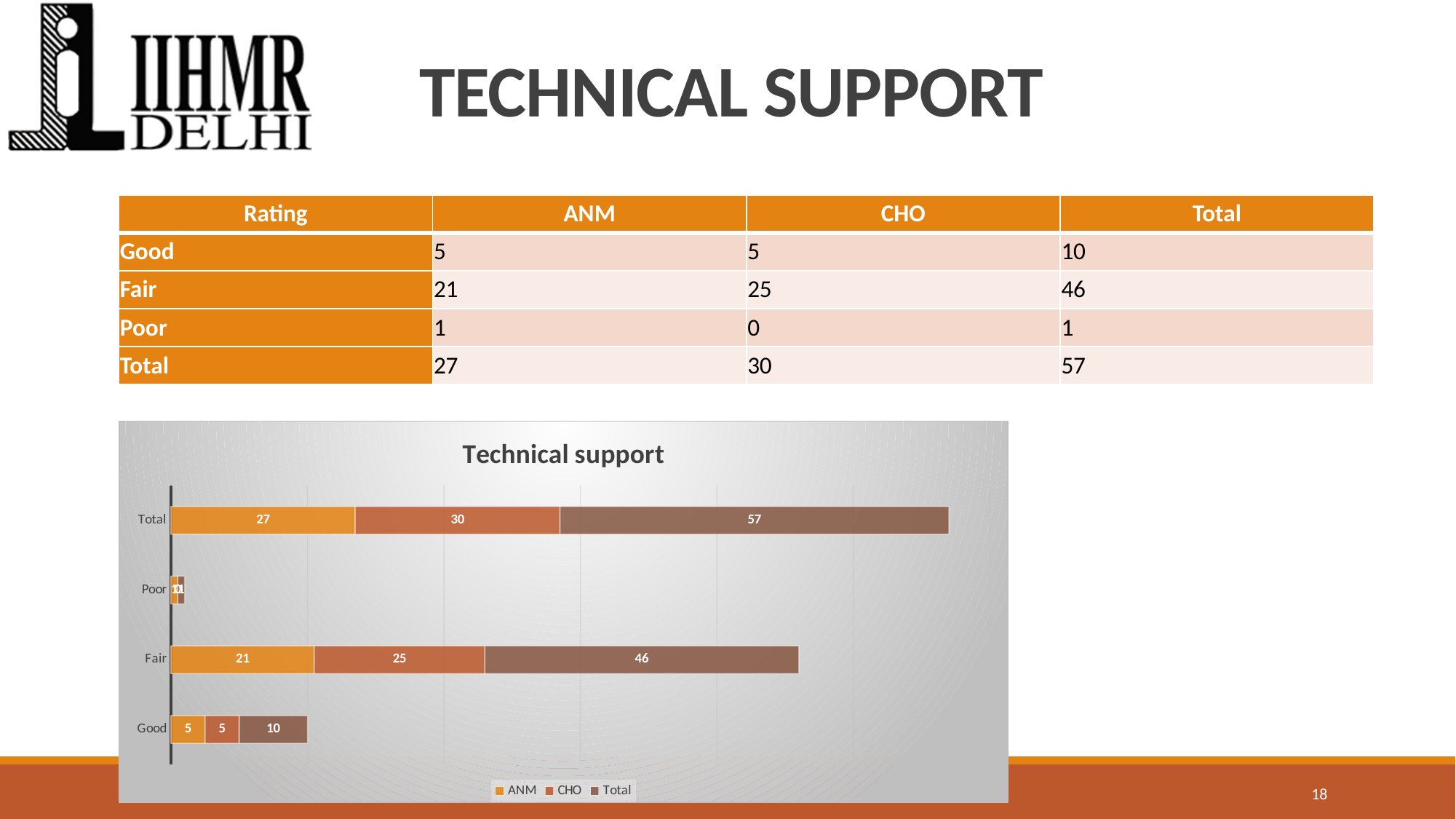
What is the title of the chart? Technical support Which category has the lowest ANM value in the chart? Poor What is the CHO value for the Total category in the chart? 30 How many series does the chart legend list? 3 Which category has the highest CHO value in the chart? Total How many categories are shown on the chart's vertical axis? 4 Which series is shown in the darkest brown colour in the chart? Total What type of chart is shown on the slide? stacked bar chart What is the ANM value for the Fair category in the chart? 21 What is the difference between the CHO and ANM values for the Fair category? 4 What is the Total series value for the Good category in the chart? 10 For the Good category, is the ANM value or the Total series value larger? Total